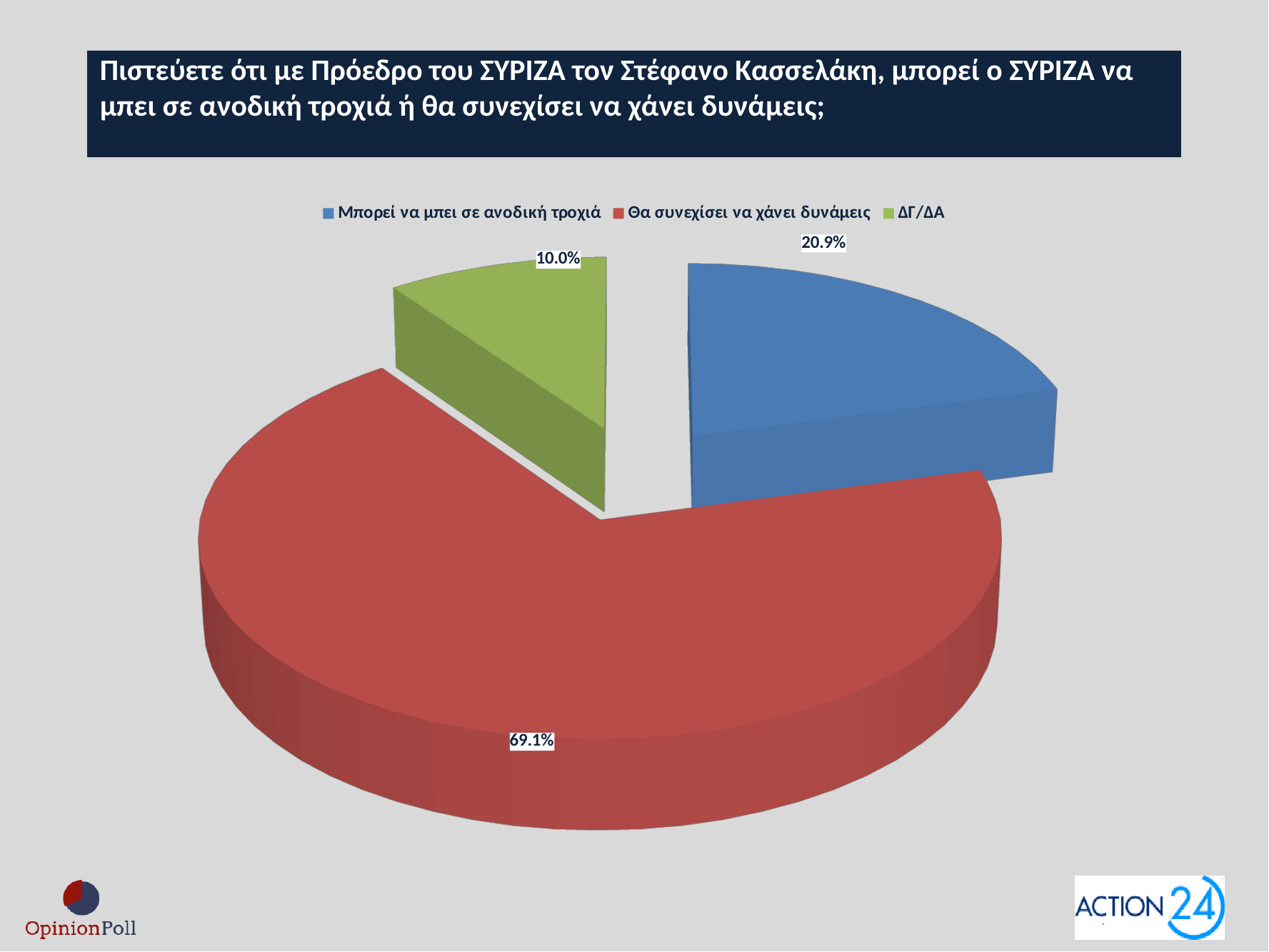
Which response has the largest share of the pie? Θα συνεχίσει να χάνει δυνάμεις How many slices does the pie chart have? 3 What percentage of respondents answered "Μπορεί να μπει σε ανοδική τροχιά"? 20.9% What percentage of respondents answered "ΔΓ/ΔΑ"? 10.0% What is the difference in percentage points between "Θα συνεχίσει να χάνει δυνάμεις" and "Μπορεί να μπει σε ανοδική τροχιά"? 48.2 Which is larger: the share for "Μπορεί να μπει σε ανοδική τροχιά" or the share for "ΔΓ/ΔΑ"? Μπορεί να μπει σε ανοδική τροχιά What colour is the slice for "ΔΓ/ΔΑ"? Green What colour is the slice for "Θα συνεχίσει να χάνει δυνάμεις"? Red What is the difference in percentage points between "Μπορεί να μπει σε ανοδική τροχιά" and "ΔΓ/ΔΑ"? 10.9 What percentage of respondents answered "Θα συνεχίσει να χάνει δυνάμεις"? 69.1% Which response has the smallest share of the pie? ΔΓ/ΔΑ What kind of chart is shown on the slide? Pie chart